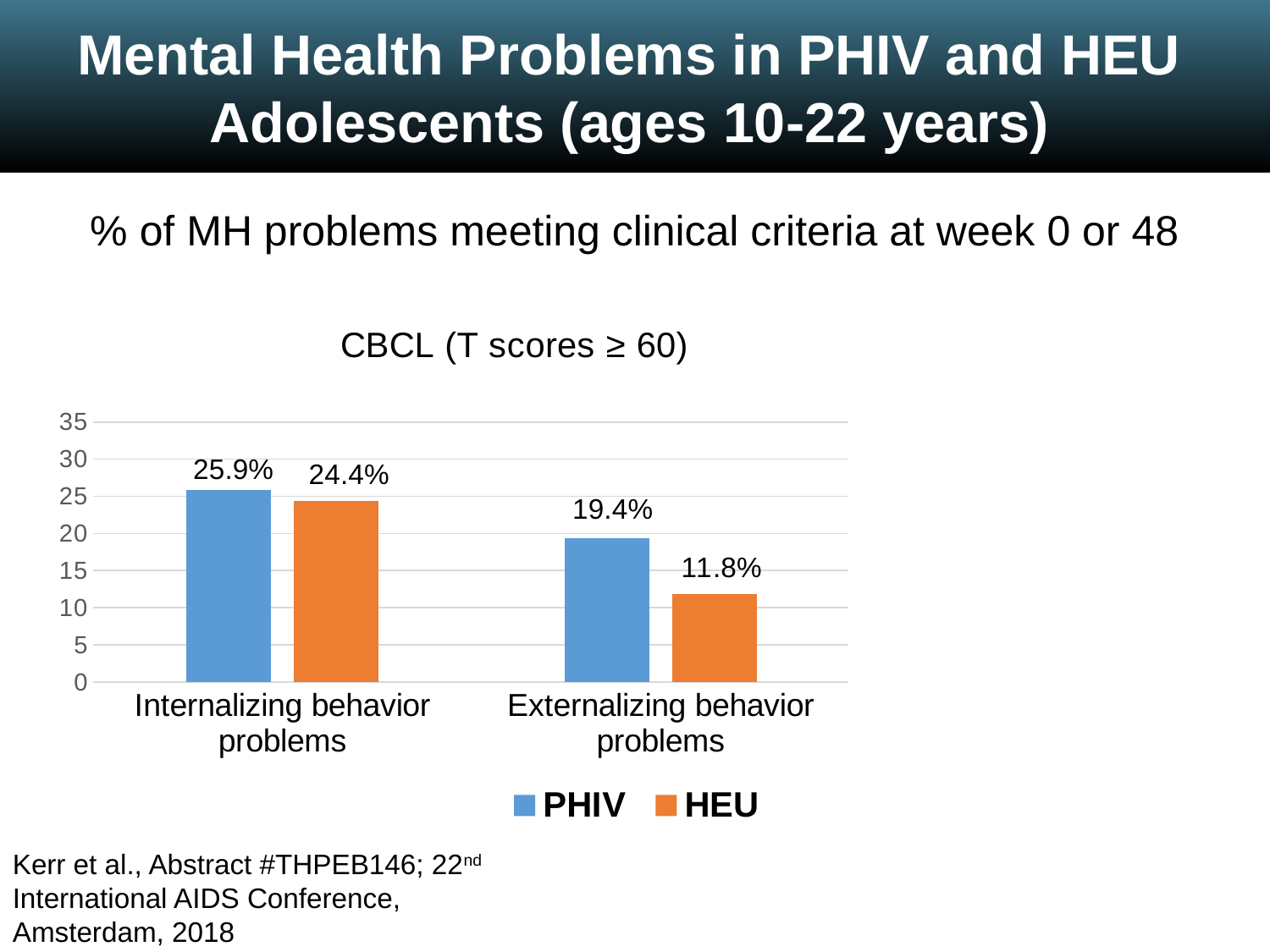
Which bar has the lowest value in the chart? HEU, Externalizing behavior problems How many categories are shown on the x axis? 2 What is the HEU value for Internalizing behavior problems? 24.4% What kind of chart is shown on the slide? bar chart Which bar has the highest value in the chart? PHIV, Internalizing behavior problems What is the HEU value for Externalizing behavior problems? 11.8% How many series does the legend list? 2 Which is larger for Internalizing behavior problems, PHIV or HEU? PHIV What is the PHIV value for Internalizing behavior problems? 25.9% What is the difference between the PHIV and HEU values for Externalizing behavior problems? 7.6% Is the HEU value for Externalizing behavior problems greater or less than 15? less What is the PHIV value for Externalizing behavior problems? 19.4%